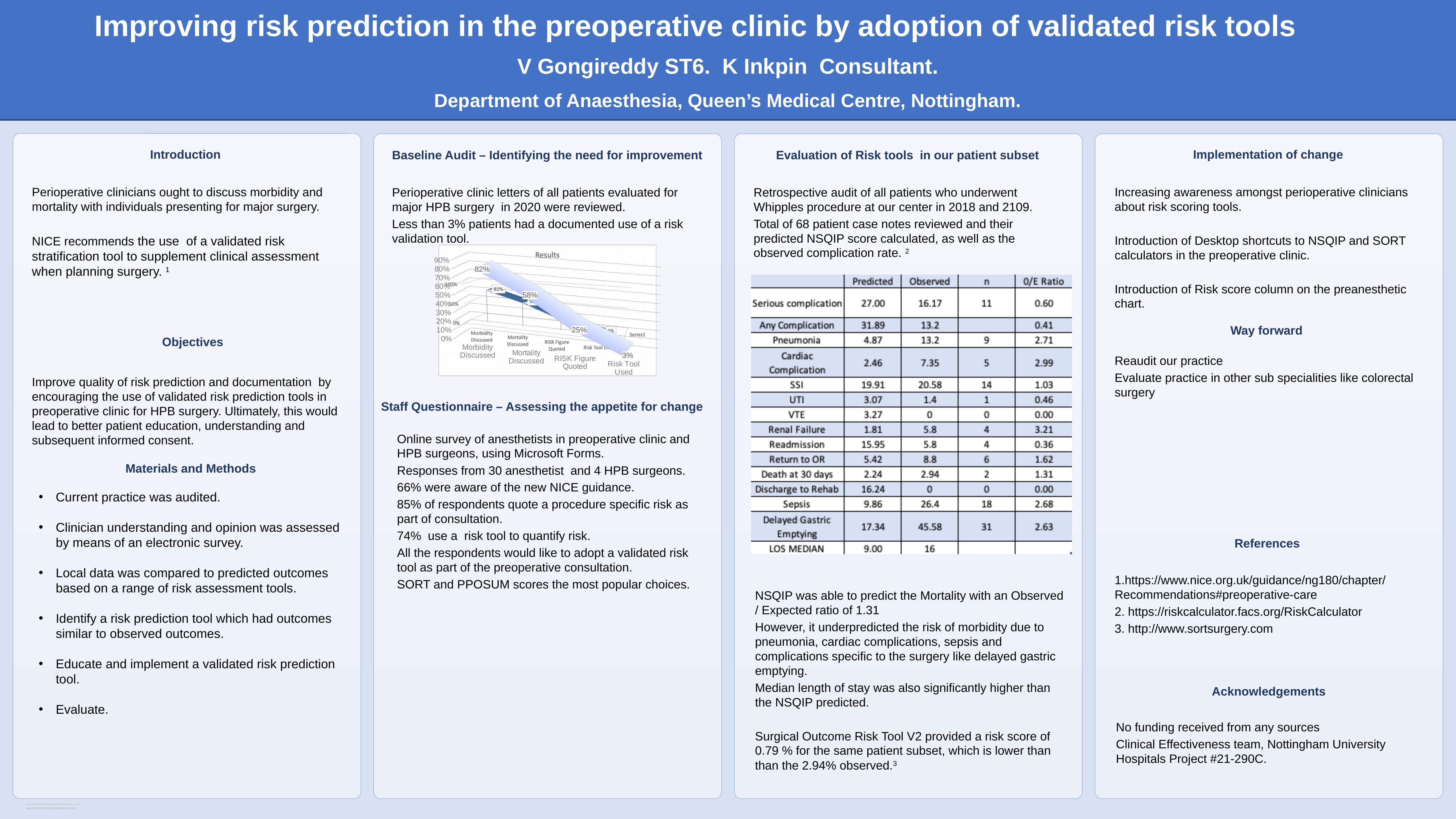
How many categories are plotted in the Results chart? 4 In the Results chart, do the values rise or fall from Morbidity Discussed to Risk Tool Used? fall In the Results chart, what is the value for RISK Figure Quoted? 25% In the Results chart, what is the value for Morbidity Discussed? 82% In the Results chart, which category has the highest value? Morbidity Discussed In the Results chart, what is the value for Risk Tool Used? 3% In the Results chart, which is larger: the value for Mortality Discussed or the value for RISK Figure Quoted? Mortality Discussed In the Results chart, what is the difference between the values for Morbidity Discussed and Mortality Discussed? 24 percentage points What is the title of the chart in the Baseline Audit section? Results In the Results chart, which category has the lowest value? Risk Tool Used How many series does the legend of the Results chart list? 1 In the Results chart, what is the value for Mortality Discussed? 58%